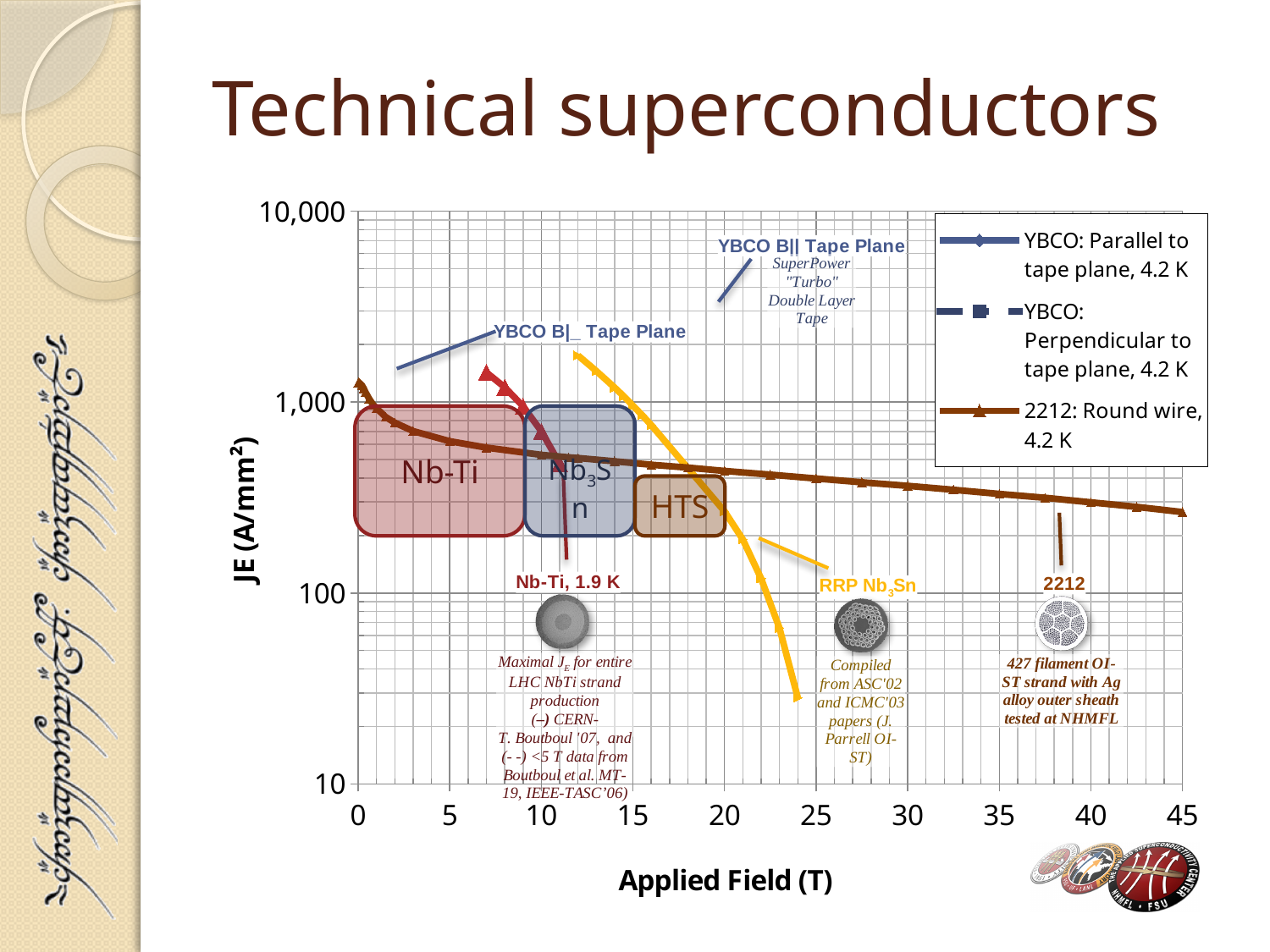
What kind of chart is shown on the slide? line chart Does the 2212 round wire curve rise or fall as the applied field increases? fall Is the lowest point of the RRP Nb3Sn curve greater or less than 100? less Which curve extends to the highest applied field on the chart? 2212: Round wire, 4.2 K Is the value of the 2212 round wire curve at 45 T greater or less than 100? greater What is the highest value shown on the x axis? 45 How many series does the chart legend list? 3 Is the value of the 2212 round wire curve at 20 T greater or less than 1,000? less What is the label of the y axis? JE (A/mm²) What is the highest value shown on the y axis? 10,000 At what temperature is the Nb-Ti curve labelled? 1.9 K What is the label of the x axis? Applied Field (T)